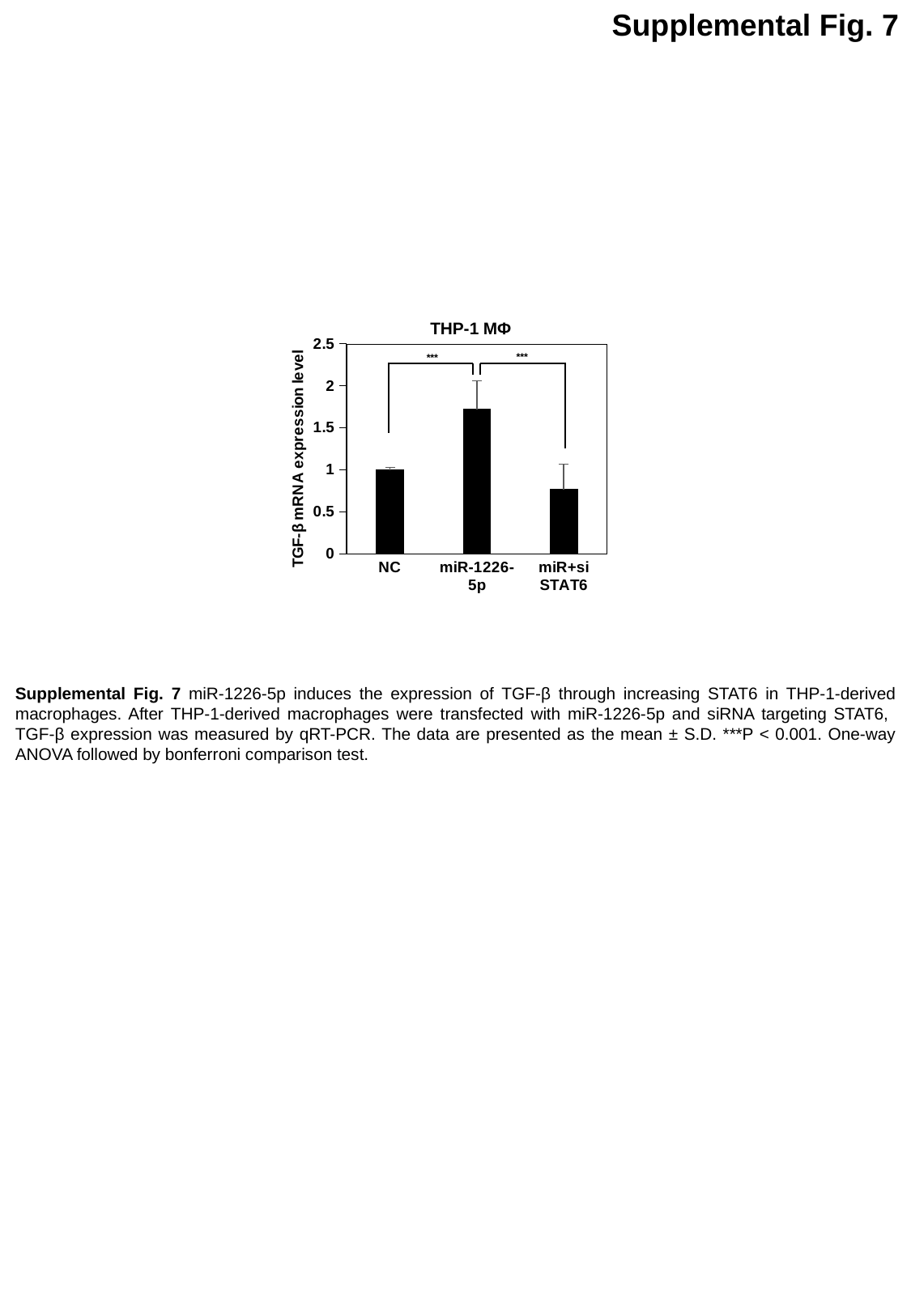
What is the TGF-β mRNA expression level for NC? 1 Is the value for miR-1226-5p greater or less than 1.5? greater How many categories are shown on the x axis? 3 What is the label of the y axis? TGF-β mRNA expression level What kind of chart is shown on the slide? bar chart Is the value for miR-1226-5p greater or less than 2? less Which is larger, the value for miR-1226-5p or the value for NC? miR-1226-5p What is the title of the chart? THP-1 MΦ Which is larger, the value for NC or the value for miR+si STAT6? NC Is the value for miR+si STAT6 greater or less than 1? less Which category has the highest TGF-β mRNA expression level? miR-1226-5p Which category has the lowest TGF-β mRNA expression level? miR+si STAT6